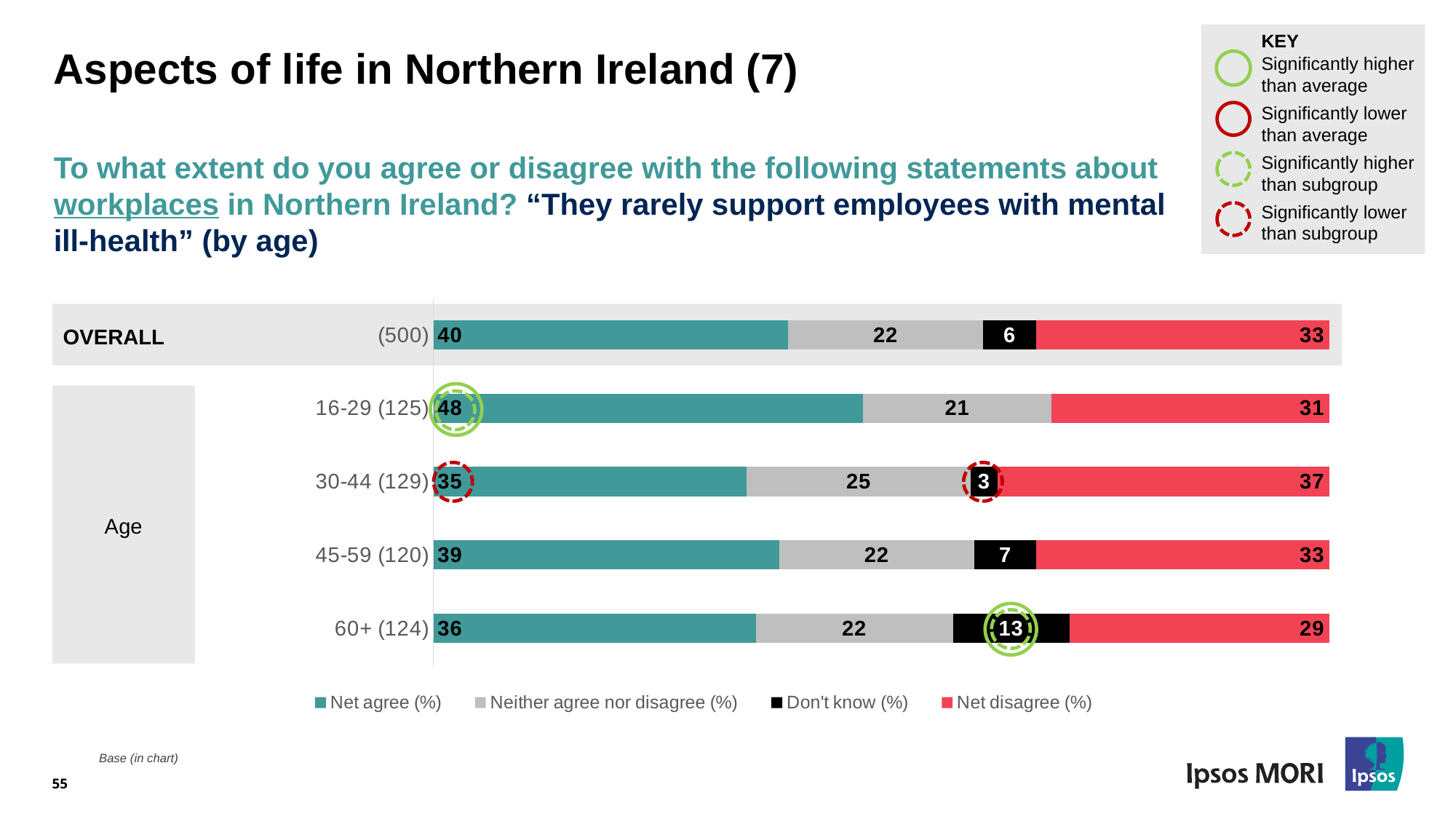
Which age group has the highest Net agree (%) value? 16-29 How many series does the legend list? 4 What is the Don't know (%) value for the 60+ age group? 13 Which is larger, the Net disagree (%) value for 45-59 or for 60+? 45-59 What is the Neither agree nor disagree (%) value for the 30-44 age group? 25 What is the base size shown for the 45-59 age group? 120 Which age group has the lowest Net disagree (%) value? 60+ What is the Net agree (%) value for the OVERALL group? 40 How many age groups (excluding OVERALL) are shown in the chart? 4 What is the Net disagree (%) value for the 30-44 age group? 37 What is the difference between the Net agree (%) values for the 16-29 and 30-44 age groups? 13 What kind of chart is shown on the slide? Stacked bar chart